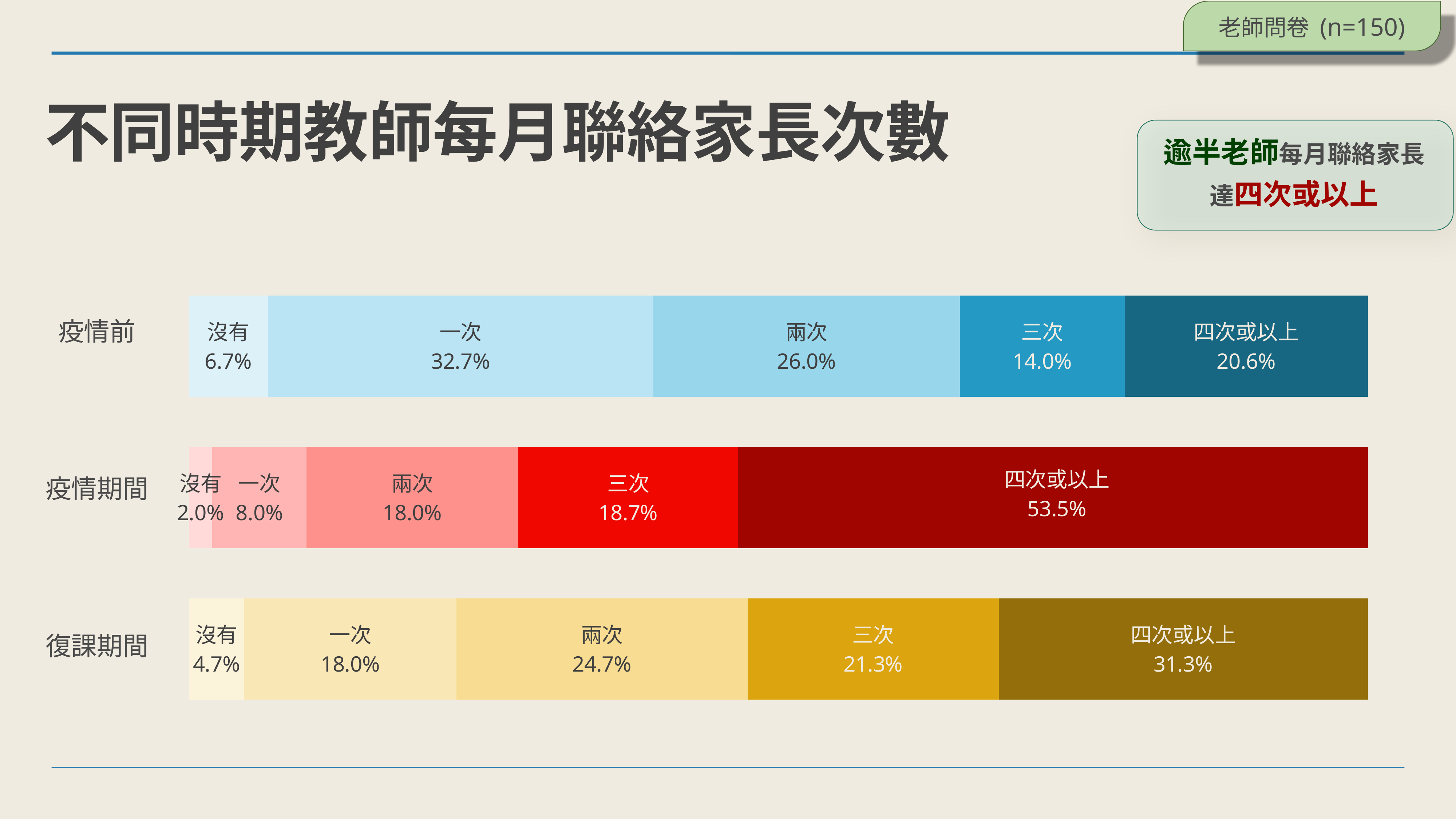
Which category has the smallest share in the 復課期間 bar? 沒有 What is the value for 兩次 in the 復課期間 bar? 24.7% What is the difference between the 四次或以上 share in 疫情期間 and in 疫情前? 32.9 percentage points What is the value for 沒有 in the 疫情期間 bar? 2.0% How many time periods (bars) are shown in the chart? 3 What is the title of the chart on the slide? 不同時期教師每月聯絡家長次數 How many categories of contact frequency does each bar contain? 5 What is the value for 一次 in the 疫情前 bar? 32.7% Which category has the largest share in the 疫情前 bar? 一次 What is the value for 四次或以上 in the 疫情期間 bar? 53.5% What kind of chart is shown on the slide? Stacked bar chart Which is larger: the 三次 share in 疫情前 or the 三次 share in 復課期間? 復課期間